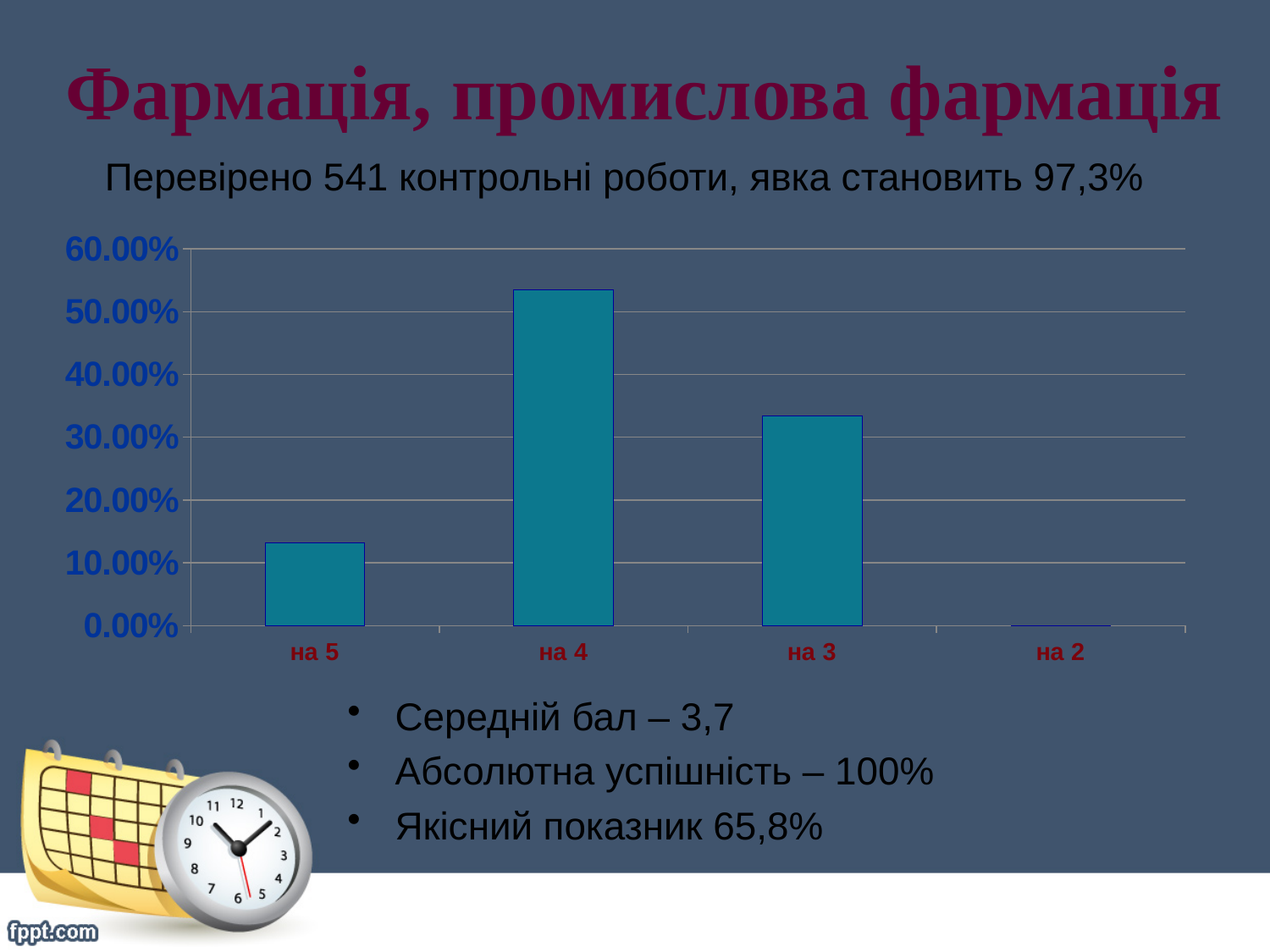
Is the value for на 4 greater or less than 50.00%? greater Do the values rise or fall along the x axis from на 4 to на 2? fall Which category has the highest bar in the chart? на 4 Is the value for на 3 greater or less than 30.00%? greater Is the value for на 3 greater or less than 40.00%? less What kind of chart is shown on the slide? bar chart What is the highest value shown on the chart's vertical axis? 60.00% Which is larger, the value for на 3 or the value for на 5? на 3 Which category has the lowest bar in the chart? на 2 How many categories are shown on the x axis of the chart? 4